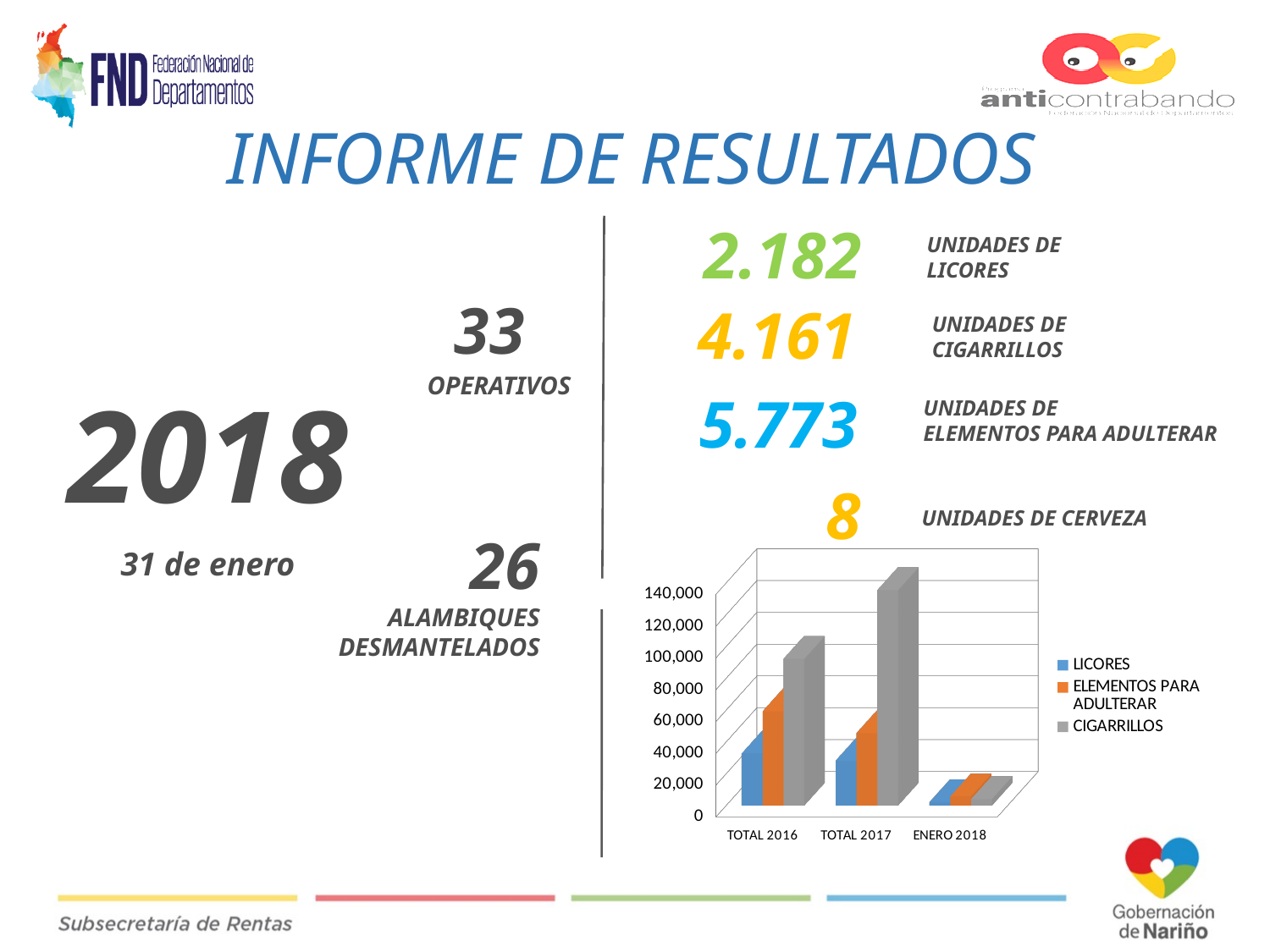
In TOTAL 2016, which is larger: LICORES or CIGARRILLOS? CIGARRILLOS Which category has the highest CIGARRILLOS bar? TOTAL 2017 Is the value for CIGARRILLOS in ENERO 2018 greater or less than 20,000? less Is the value for CIGARRILLOS in TOTAL 2017 greater or less than 100,000? greater Is the CIGARRILLOS bar larger for TOTAL 2016 or TOTAL 2017? TOTAL 2017 Which series is shown in gray in the chart legend? CIGARRILLOS Which category has the lowest bars overall in the chart? ENERO 2018 What kind of chart is shown on the slide? bar chart How many series does the chart legend list? 3 Is the value for LICORES in TOTAL 2016 greater or less than 60,000? less How many categories are shown on the x axis of the chart? 3